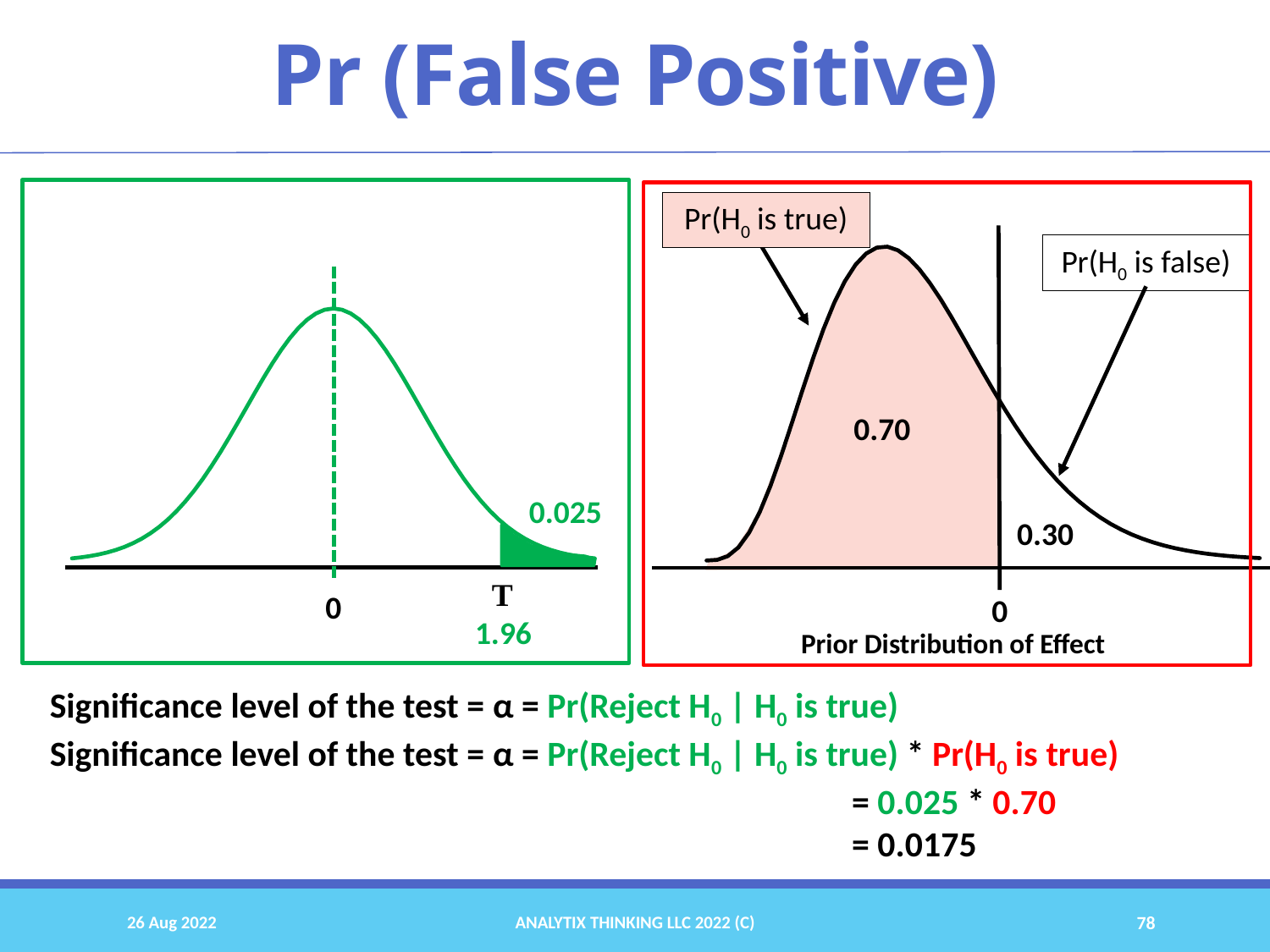
In the right chart titled 'Prior Distribution of Effect', what is the printed value of the shaded area labelled Pr(H0 is true)? 0.70 In the left chart, what is the value of the threshold T printed below the axis? 1.96 In the left chart, is the shaded tail probability 0.025 greater or less than 0.70? less In the right chart, what is the difference between Pr(H0 is true) and Pr(H0 is false)? 0.40 In the left chart, what value is printed at the centre of the distribution on the x axis? 0 What is the x-axis label of the right chart? Prior Distribution of Effect In the right chart titled 'Prior Distribution of Effect', what is the printed value for Pr(H0 is false)? 0.30 In the right chart, what is the total of the two printed probabilities 0.70 and 0.30? 1.00 In the right chart, which is larger, Pr(H0 is true) or Pr(H0 is false)? Pr(H0 is true) What kind of chart is shown in the left panel? A curve (normal distribution) chart What is the final computed value of Pr(False Positive) shown on the slide? 0.0175 In the left chart, what is the printed probability of the shaded tail area to the right of T? 0.025